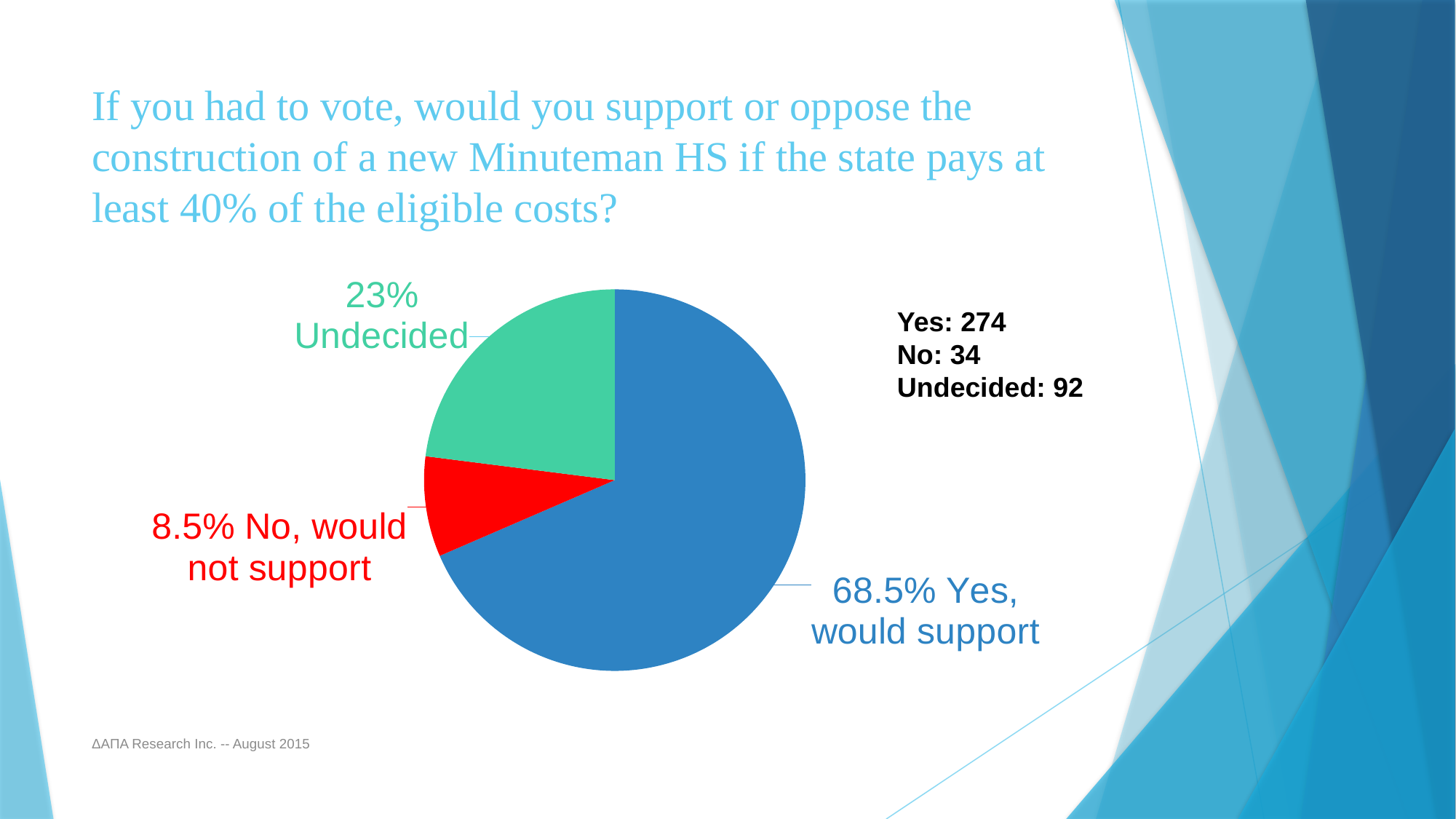
Which response has the smallest slice of the pie? No, would not support Which response has the largest slice of the pie? Yes, would support How many respondents were Undecided according to the text beside the chart? 92 What percentage of respondents were Undecided? 23% What is the difference in percentage points between Yes, would support and No, would not support? 60 percentage points What kind of chart is shown on the slide? pie chart What percentage of respondents said Yes, would support? 68.5% How many slices does the pie chart have? 3 How many respondents answered No according to the text beside the chart? 34 What colour is the Undecided slice? green What percentage of respondents said No, would not support? 8.5% How many respondents answered Yes according to the text beside the chart? 274